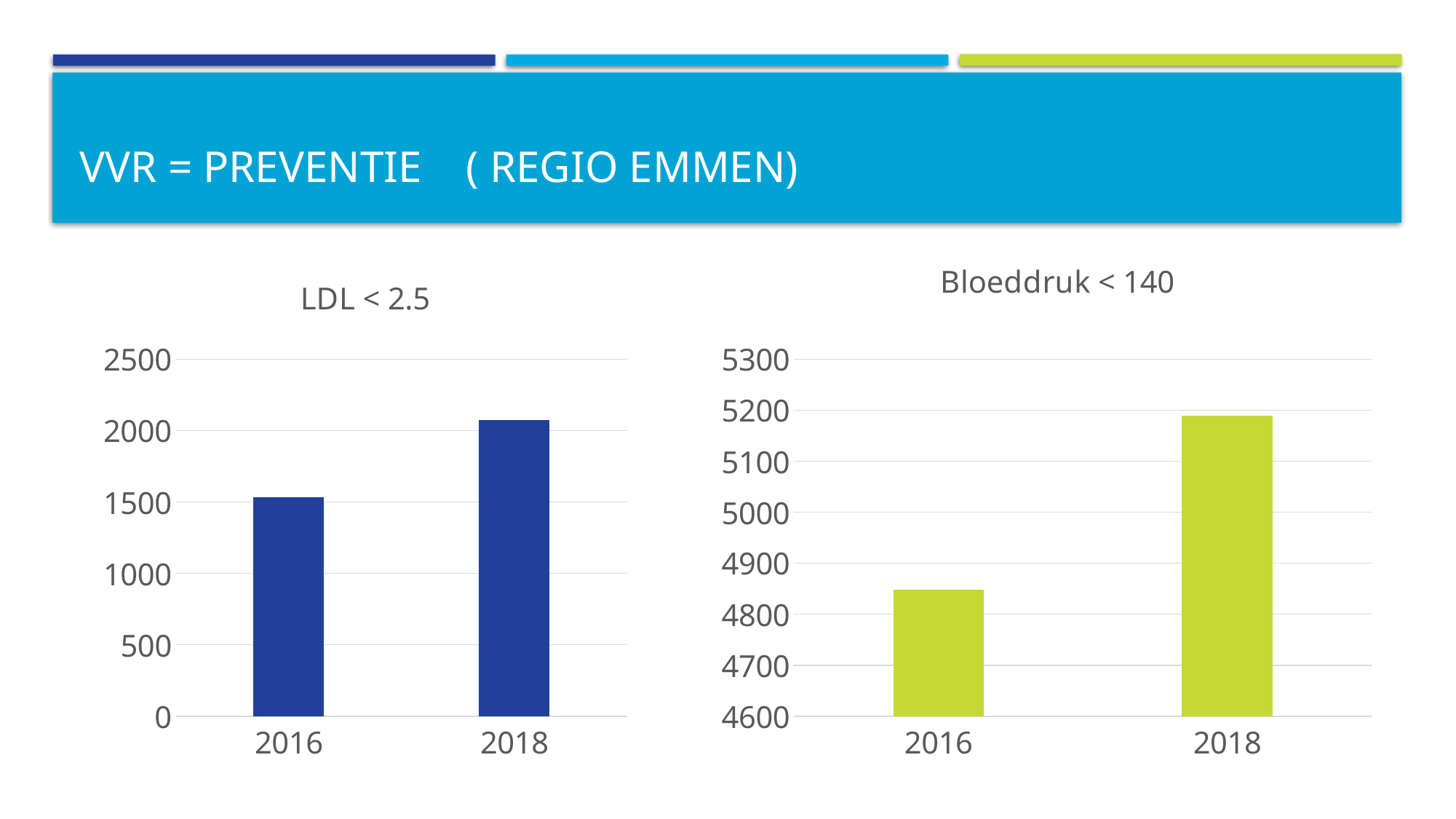
In the 'Bloeddruk < 140' chart, do the values rise or fall from 2016 to 2018? rise In the 'Bloeddruk < 140' chart, is the value for 2016 greater or less than 4900? less In the 'Bloeddruk < 140' chart, which year has the higher value? 2018 In the 'LDL < 2.5' chart, which year has the lower value? 2016 In the 'Bloeddruk < 140' chart, is the value for 2018 greater or less than 5100? greater In the 'LDL < 2.5' chart, is the value for 2018 greater or less than 2000? greater What colour are the bars in the 'Bloeddruk < 140' chart? green What kind of chart is the 'LDL < 2.5' chart? bar chart In the 'LDL < 2.5' chart, how many bars are plotted? 2 In the 'LDL < 2.5' chart, which year has the higher value? 2018 What is the title of the chart on the right side of the slide? Bloeddruk < 140